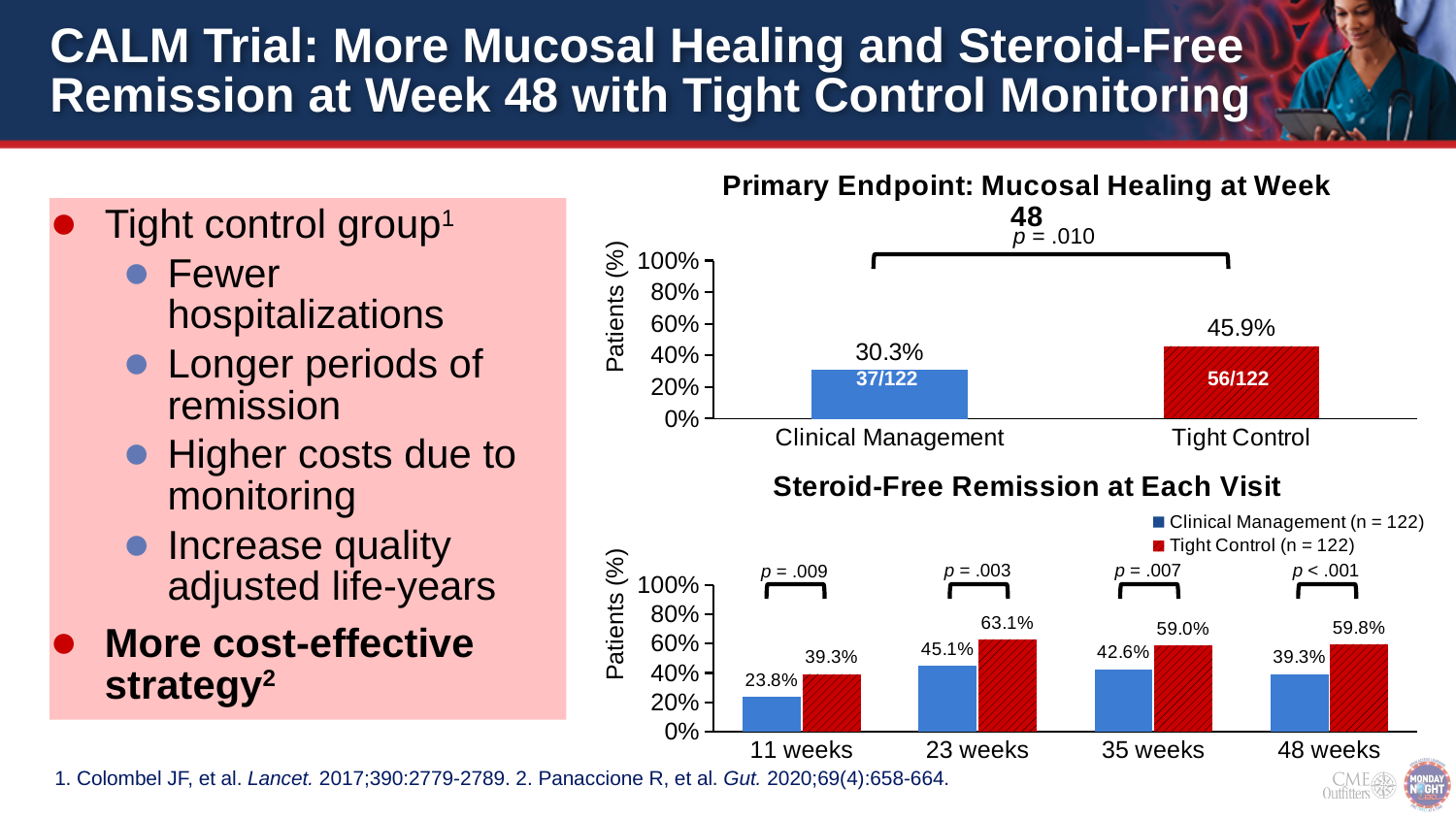
How many series does the legend of the 'Steroid-Free Remission at Each Visit' chart list? 2 In the 'Steroid-Free Remission at Each Visit' chart, what is the Clinical Management value at 11 weeks? 23.8% In the 'Primary Endpoint: Mucosal Healing at Week 48' chart, what is the value for Clinical Management? 30.3% In the 'Steroid-Free Remission at Each Visit' chart, what is the difference between Tight Control and Clinical Management at 48 weeks? 20.5% In the 'Primary Endpoint: Mucosal Healing at Week 48' chart, what is the difference between the Tight Control and Clinical Management values? 15.6% In the 'Steroid-Free Remission at Each Visit' chart, at which visit is the Tight Control value highest? 23 weeks In the 'Steroid-Free Remission at Each Visit' chart, what is the Tight Control value at 23 weeks? 63.1% How many visit categories are shown on the x axis of the 'Steroid-Free Remission at Each Visit' chart? 4 In the 'Primary Endpoint: Mucosal Healing at Week 48' chart, what p-value is shown? p = .010 In the 'Primary Endpoint: Mucosal Healing at Week 48' chart, what fraction is printed on the Tight Control bar? 56/122 In the 'Steroid-Free Remission at Each Visit' chart, at which visit is the Clinical Management value lowest? 11 weeks In the 'Primary Endpoint: Mucosal Healing at Week 48' chart, what is the value for Tight Control? 45.9%